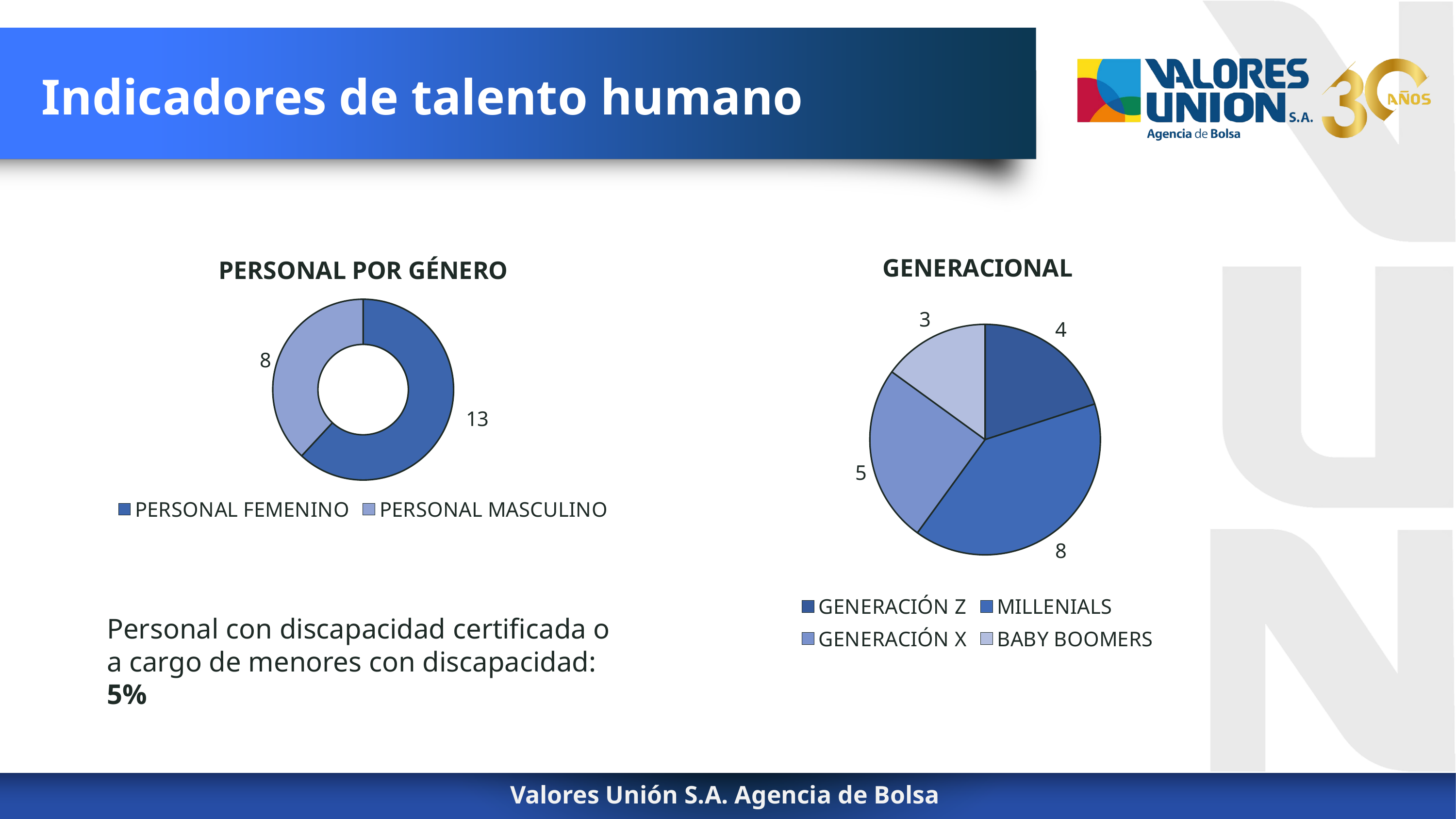
In the PERSONAL POR GÉNERO chart, what is the value for PERSONAL MASCULINO? 8 In the GENERACIONAL chart, what is the difference between MILLENIALS and GENERACIÓN Z? 4 In the GENERACIONAL chart, what share of the pie does MILLENIALS represent? 40% What kind of chart is the PERSONAL POR GÉNERO chart? Doughnut chart In the GENERACIONAL chart, how many categories does the legend list? 4 In the GENERACIONAL chart, what is the value for MILLENIALS? 8 In the PERSONAL POR GÉNERO chart, what is the difference between PERSONAL FEMENINO and PERSONAL MASCULINO? 5 In the GENERACIONAL chart, which category has the lowest value? BABY BOOMERS In the GENERACIONAL chart, what is the value for GENERACIÓN X? 5 In the PERSONAL POR GÉNERO chart, what is the value for PERSONAL FEMENINO? 13 In the PERSONAL POR GÉNERO chart, which category is larger, PERSONAL FEMENINO or PERSONAL MASCULINO? PERSONAL FEMENINO In the GENERACIONAL chart, which category has the highest value? MILLENIALS